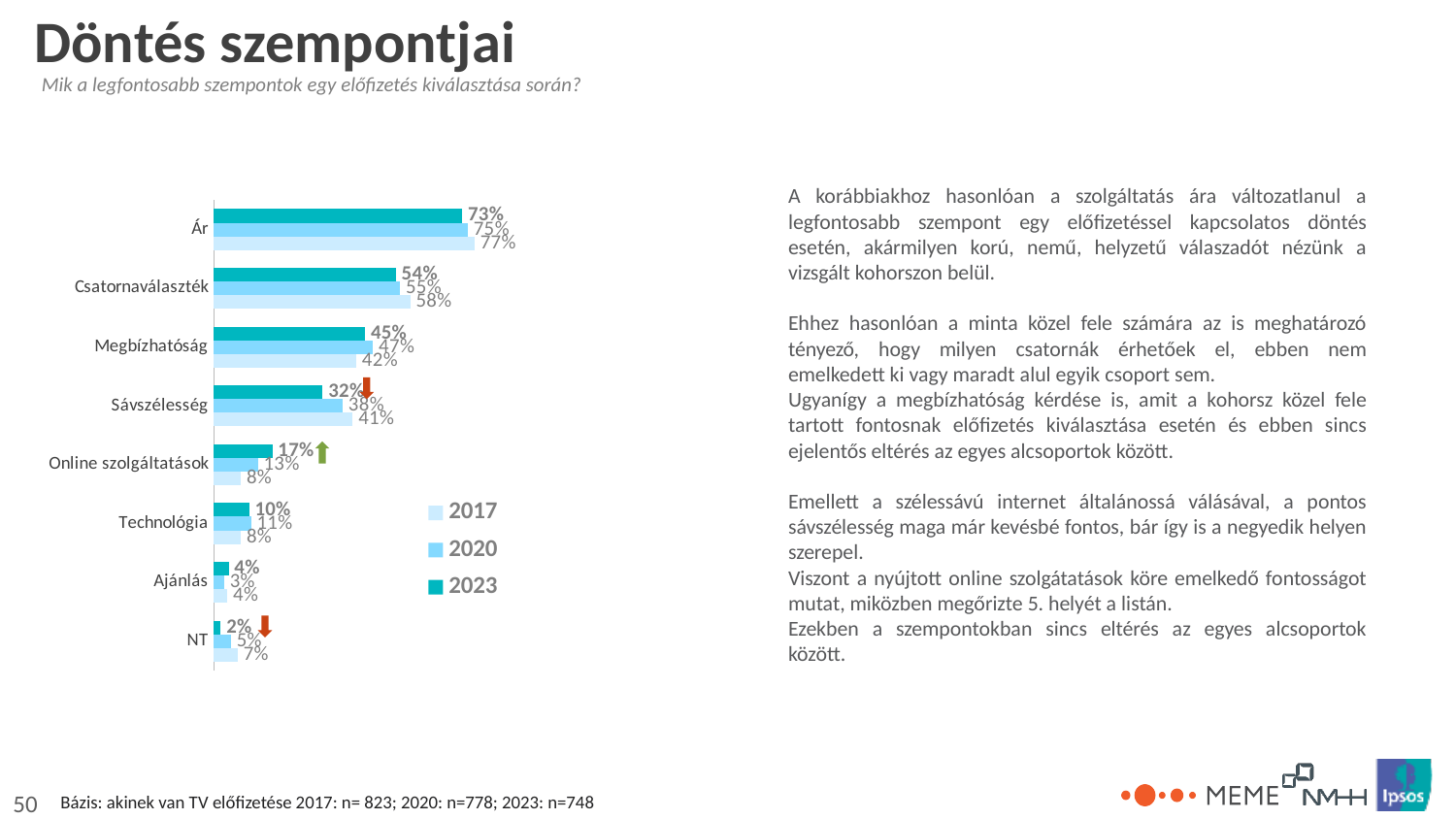
What is the 2017 value for Sávszélesség? 41% Which category has the highest 2023 value? Ár What is the difference between the 2017 and 2023 values for Sávszélesség? 9% Which category has the lowest 2023 value? NT How many series does the legend list? 3 What is the 2020 value for Online szolgáltatások? 13% For Online szolgáltatások, which is larger: the 2023 value or the 2017 value? 2023 What is the 2023 value for Ár? 73% What kind of chart is shown on the slide? Bar chart What is the difference between the 2023 and 2017 values for Online szolgáltatások? 9% Which years are listed in the chart legend? 2017, 2020, 2023 How many categories are shown on the chart? 8